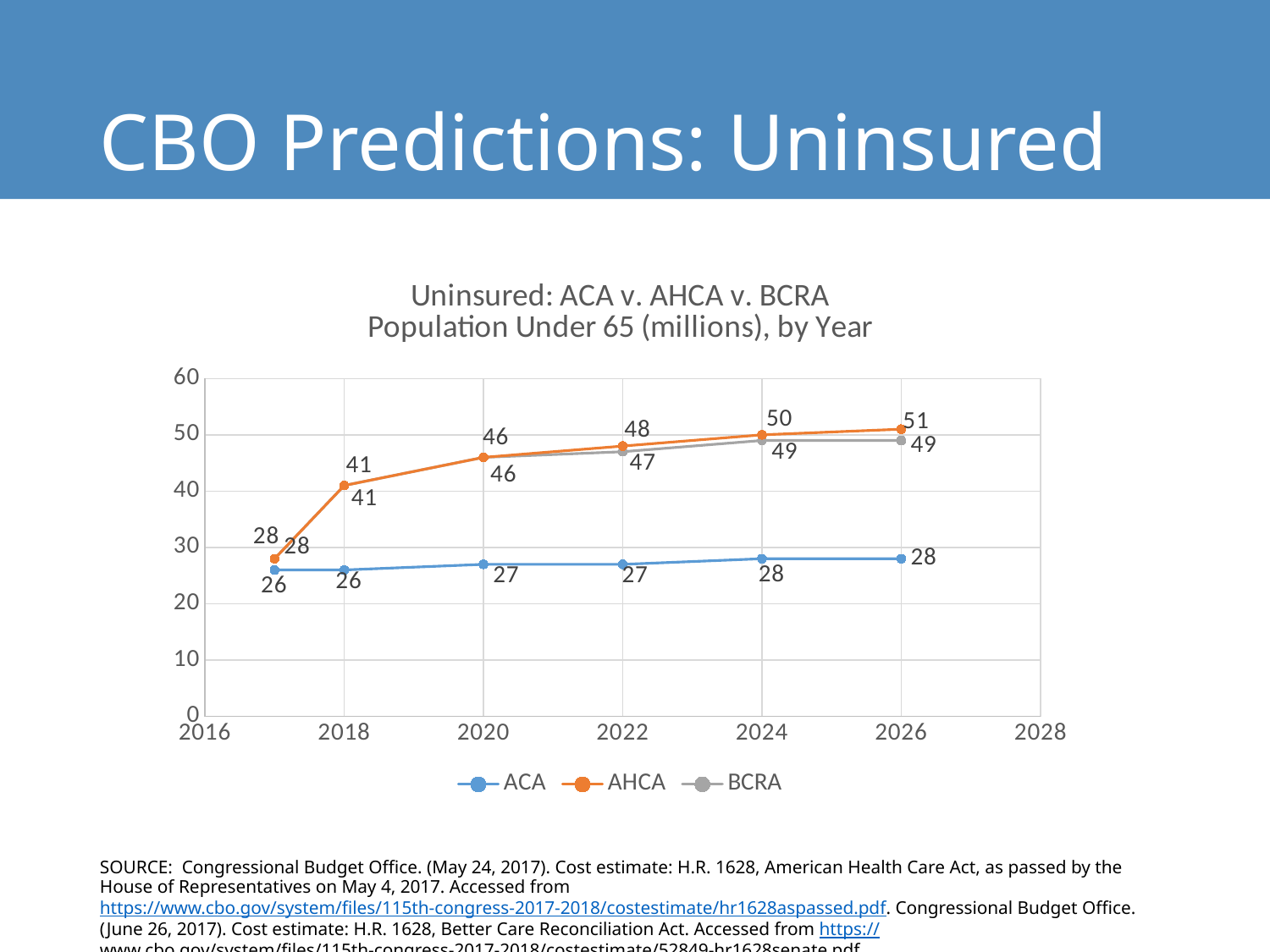
What is the difference between the AHCA and ACA values in 2026? 23 Which series has the highest value in 2026? AHCA What type of chart is shown on the slide? line chart What is the title of the chart? Uninsured: ACA v. AHCA v. BCRA Population Under 65 (millions), by Year How many series does the legend list? 3 What is the ACA value in 2020? 27 What is the AHCA value in 2026? 51 What is the BCRA value in 2024? 49 Does the AHCA series rise or fall from 2017 to 2026? rise What is the AHCA value in 2018? 41 Is the AHCA value in 2024 larger than the ACA value in 2024? yes Which series has the lowest value in 2022? ACA